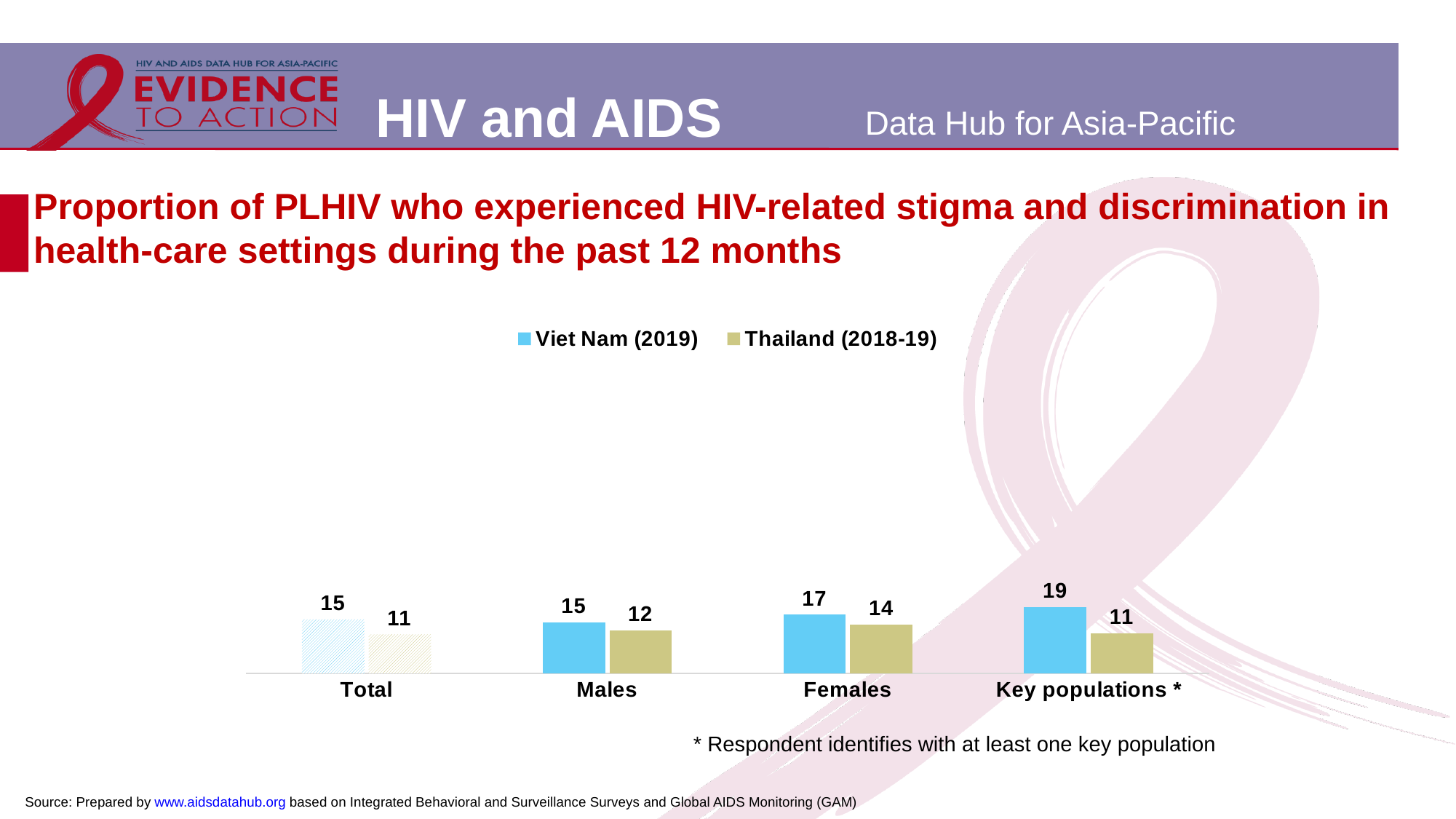
What is the difference between the Viet Nam (2019) and Thailand (2018-19) values for Key populations *? 8 What kind of chart is shown on the slide? Bar chart How many series does the legend list? 2 What is the value for Thailand (2018-19) in the Total category? 11 Which category has the highest value for Viet Nam (2019)? Key populations * Which series is shown in blue in the legend? Viet Nam (2019) What is the value for Thailand (2018-19) in the Males category? 12 Which category has the highest value for Thailand (2018-19)? Females What is the value for Viet Nam (2019) in the Females category? 17 Which is larger in the Females category: Viet Nam (2019) or Thailand (2018-19)? Viet Nam (2019) What is the value for Viet Nam (2019) in the Key populations * category? 19 How many categories are shown on the x axis? 4